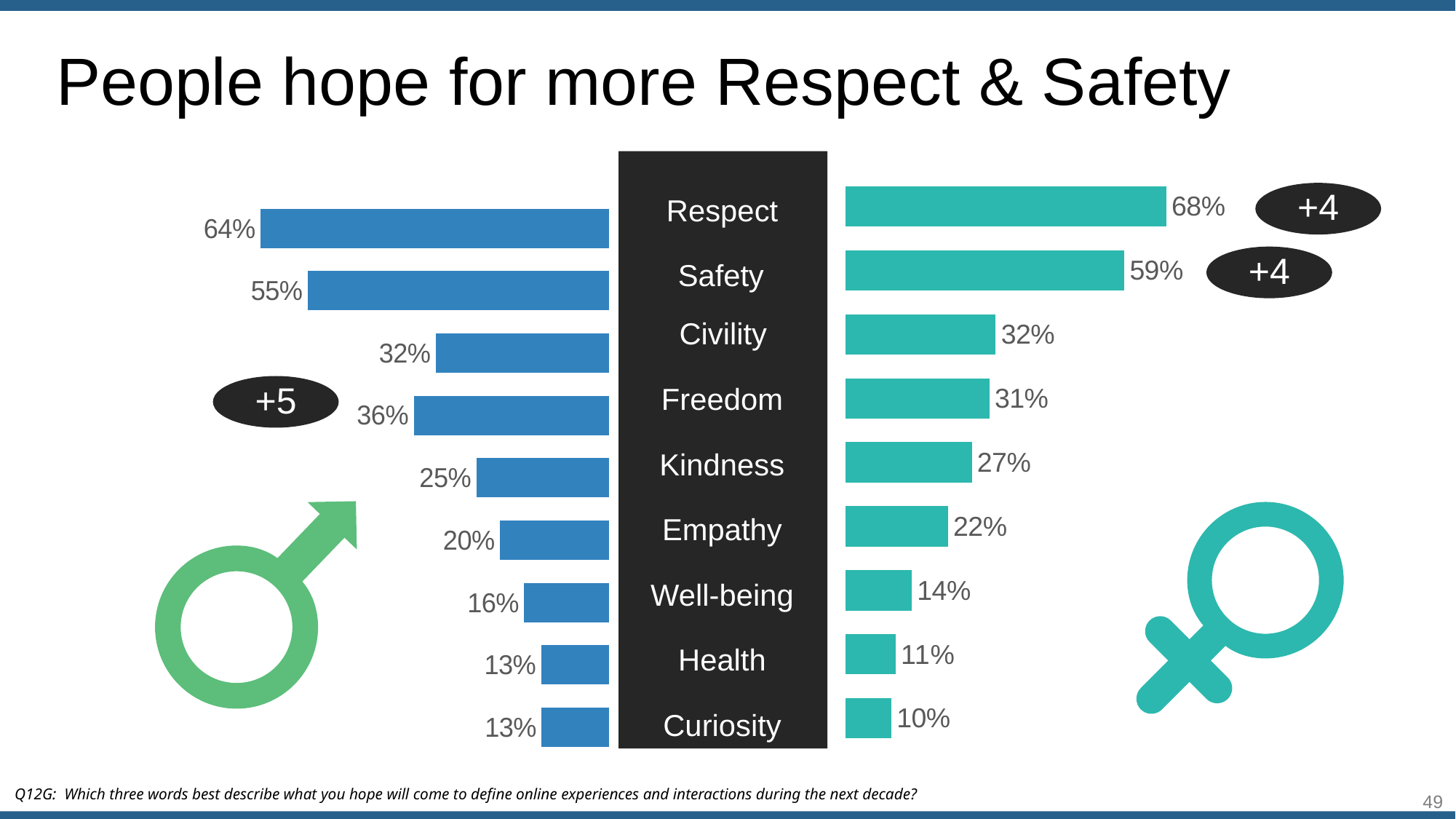
Which category has the highest value among the teal bars on the right? Respect What is the value of the teal bar on the right for Well-being? 14% What is the value of the blue bar on the left for Freedom? 36% For Kindness, which is larger: the blue bar on the left or the teal bar on the right? The teal bar on the right What type of chart is shown on the slide? Bar chart How many categories are listed in the chart? 9 Which category has the lowest value among the teal bars on the right? Curiosity What is the value of the teal bar on the right for Safety? 59% What is the difference between the left (blue) and right (teal) values for Freedom? 5% What is the value of the blue bar on the left for Respect? 64% What is the difference between the right (teal) and left (blue) values for Respect? 4% What is the title of the slide? People hope for more Respect & Safety